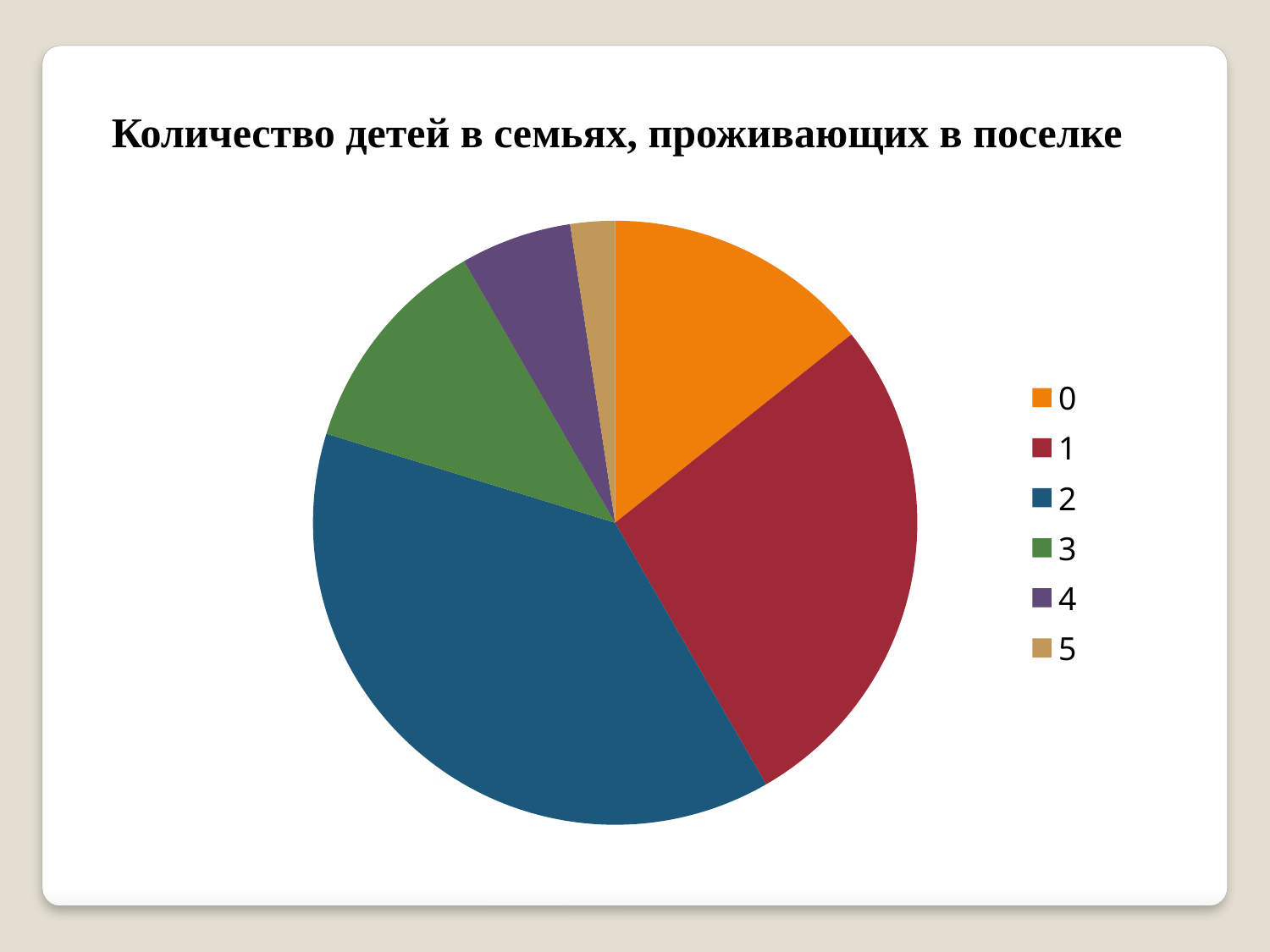
What colour is the slice for category 2? blue Which slice is larger, the one for category 4 or the one for category 5? 4 Which slice is larger, the one for category 2 or the one for category 1? 2 Which slice is larger, the one for category 3 or the one for category 4? 3 Which category has the largest slice of the pie? 2 What kind of chart is shown on the slide? pie chart Which category has the second-largest slice of the pie? 1 How many categories (slices) does the pie chart have? 6 What is the title of the chart? Количество детей в семьях, проживающих в поселке Which category has the smallest slice of the pie? 5